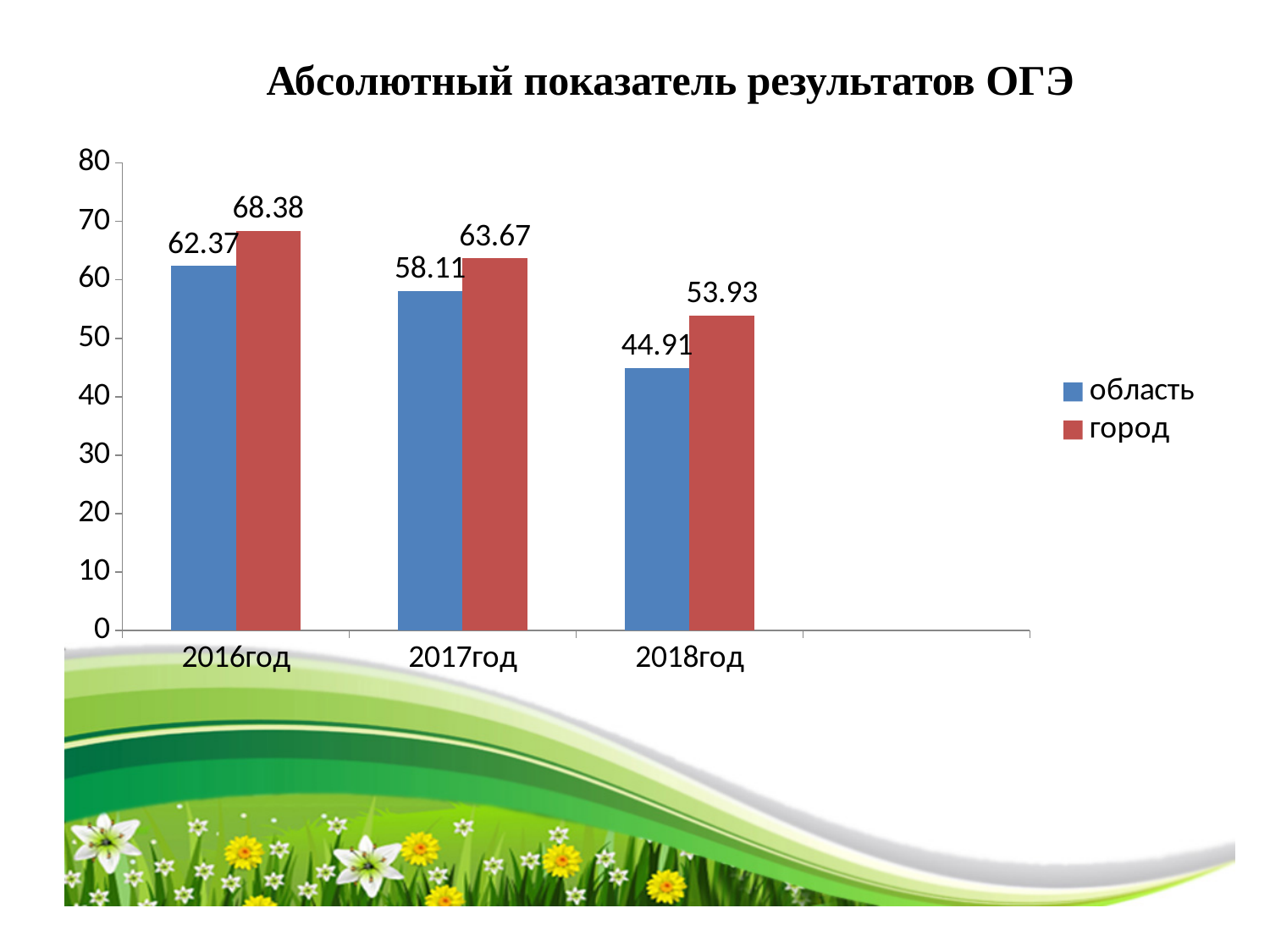
Is the value for область in 2018год greater or less than 50? less In which year is the value for область the lowest? 2018год What is the value for область in 2016год? 62.37 What is the difference between город and область in 2018год? 9.02 What is the value for город in 2017год? 63.67 How many years are shown on the x axis? 3 Do the values for город rise or fall from 2016год to 2018год? fall Which is larger in 2017год, область or город? город What is the difference between the область values for 2016год and 2017год? 4.26 In which year is the value for город the highest? 2016год How many series does the legend list? 2 What is the value for город in 2018год? 53.93